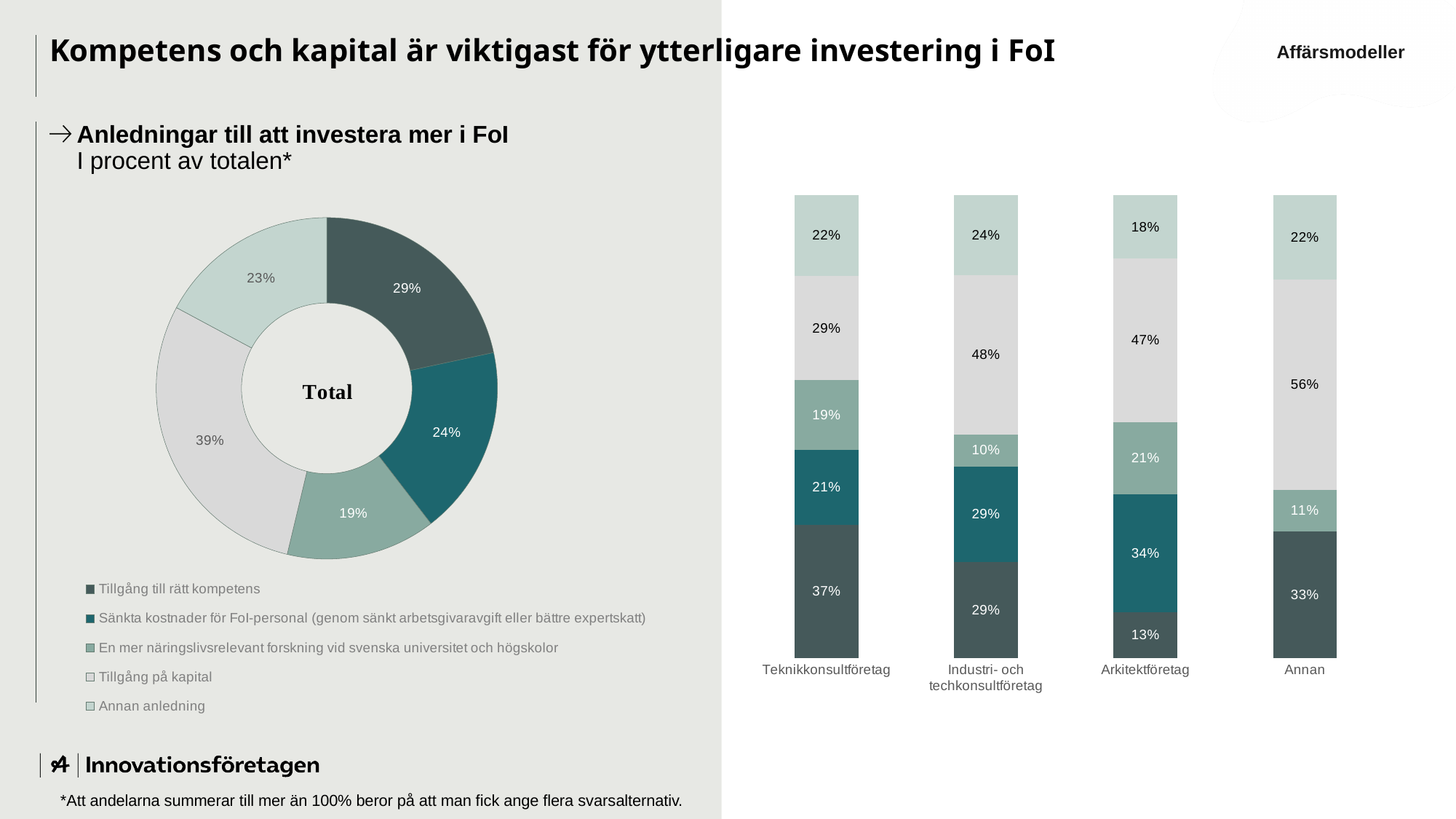
In the donut chart on the left, what share is shown for Tillgång på kapital? 39% How many entries does the legend of the donut chart on the left list? 5 In the donut chart on the left, which reason has the smallest share? En mer näringslivsrelevant forskning vid svenska universitet och högskolor In the stacked bar chart on the right, what is the value for Tillgång på kapital for Annan? 56% In the donut chart on the left, which reason has the largest share? Tillgång på kapital In the stacked bar chart on the right, what is the value for Tillgång till rätt kompetens for Teknikkonsultföretag? 37% In the stacked bar chart on the right, what is the difference between the Tillgång på kapital values for Industri- och techkonsultföretag and Teknikkonsultföretag? 19 percentage points In the stacked bar chart on the right, which is larger: the Sänkta kostnader för FoI-personal value for Arkitektföretag or for Teknikkonsultföretag? Arkitektföretag What kind of chart is the chart on the right side of the slide? Stacked bar chart In the stacked bar chart on the right, which category has the lowest value for Tillgång till rätt kompetens? Arkitektföretag In the donut chart on the left, what is the difference between the share for Tillgång på kapital and the share for Tillgång till rätt kompetens? 10 percentage points How many categories are shown on the x axis of the stacked bar chart on the right? 4